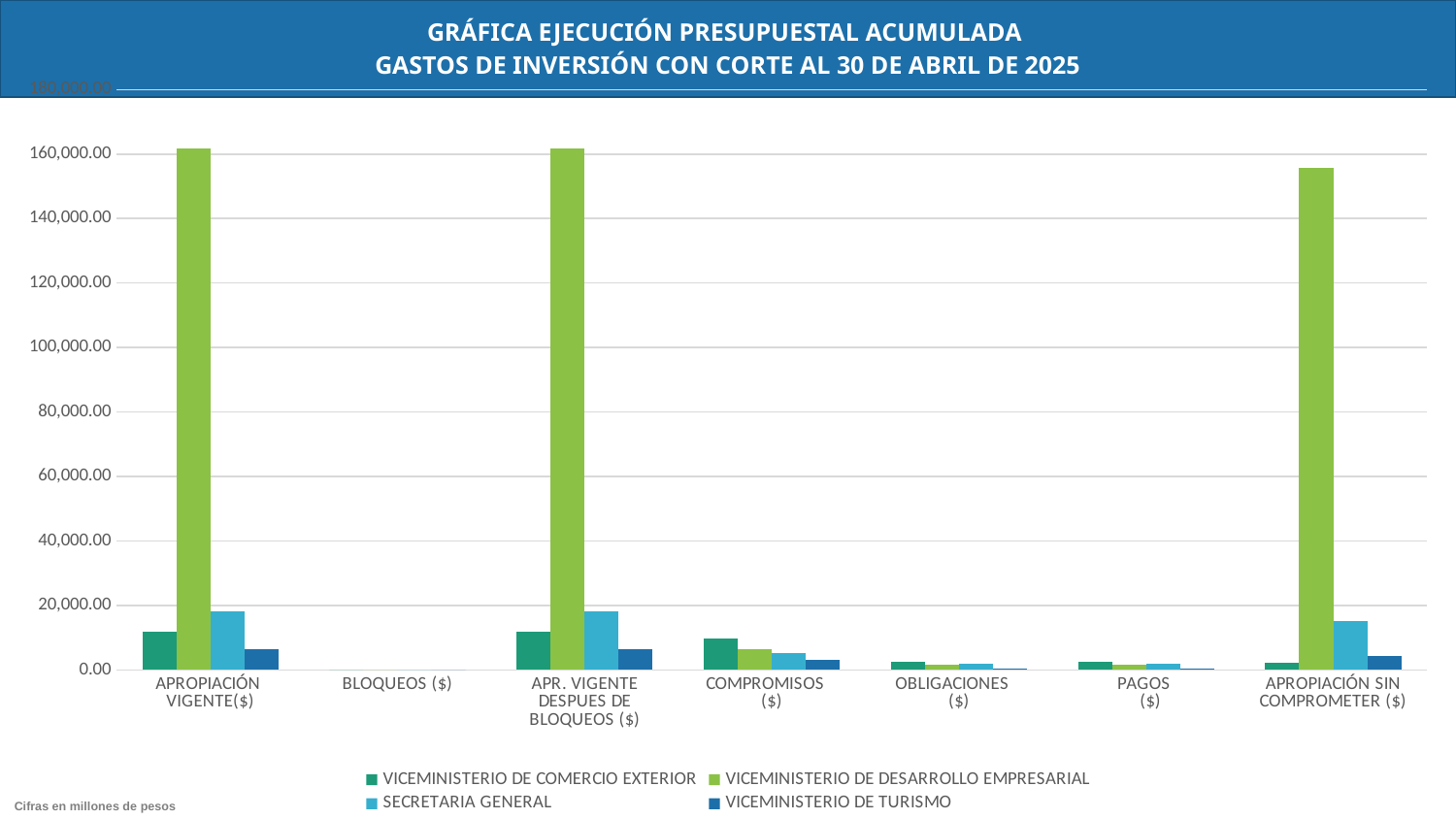
How many categories are shown along the x axis? 7 Which category has the lowest values across all series? BLOQUEOS ($) Is the value for VICEMINISTERIO DE DESARROLLO EMPRESARIAL in APROPIACIÓN SIN COMPROMETER ($) greater or less than 160,000.00? less How many series does the legend list? 4 Is the value for SECRETARIA GENERAL in APROPIACIÓN VIGENTE($) greater or less than 20,000.00? less In the APROPIACIÓN VIGENTE($) category, which is larger: SECRETARIA GENERAL or VICEMINISTERIO DE TURISMO? SECRETARIA GENERAL Is the value for VICEMINISTERIO DE DESARROLLO EMPRESARIAL in APROPIACIÓN VIGENTE($) greater or less than 140,000.00? greater Which series has the highest value in the APROPIACIÓN VIGENTE($) category? VICEMINISTERIO DE DESARROLLO EMPRESARIAL In the COMPROMISOS ($) category, which is larger: VICEMINISTERIO DE COMERCIO EXTERIOR or VICEMINISTERIO DE DESARROLLO EMPRESARIAL? VICEMINISTERIO DE COMERCIO EXTERIOR What is the cut-off date stated in the chart title? 30 DE ABRIL DE 2025 According to the note at the bottom left, in what units are the figures expressed? Millones de pesos What kind of chart is shown on the slide? Bar chart